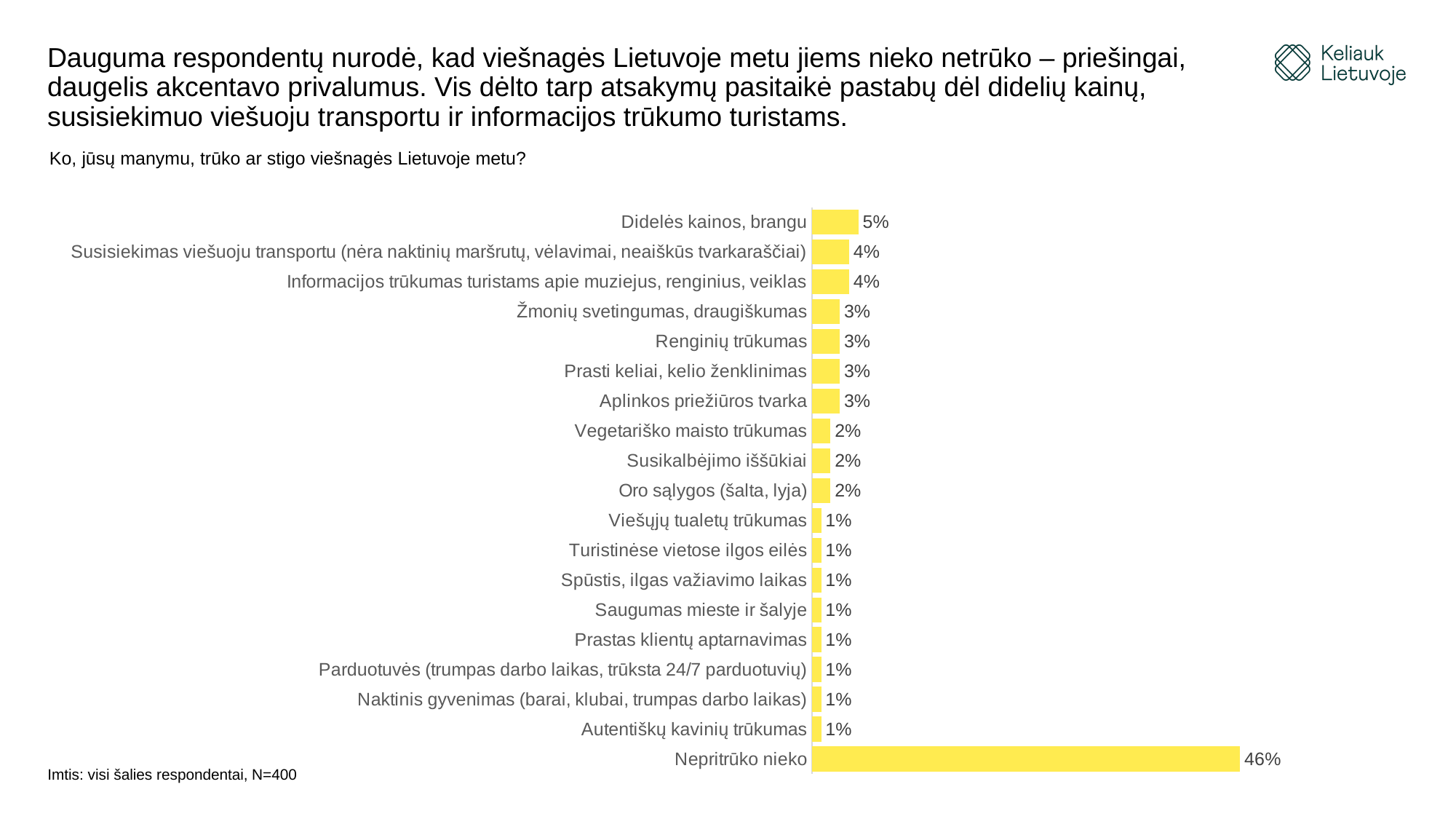
What is the value for "Oro sąlygos (šalta, lyja)"? 2% What type of chart is shown on the slide? Bar chart Which is larger: "Didelės kainos, brangu" or "Vegetariško maisto trūkumas"? Didelės kainos, brangu What colour are the bars in the chart? Yellow How many categories are shown in the chart? 19 Which category has the highest value? Nepritrūko nieko What percentage of respondents answered "Nepritrūko nieko"? 46% What is the value for "Didelės kainos, brangu"? 5% What is the difference between "Didelės kainos, brangu" and "Renginių trūkumas"? 2% What is the difference between "Nepritrūko nieko" and "Didelės kainos, brangu"? 41% What is the value for "Autentiškų kavinių trūkumas"? 1% What is the value for "Informacijos trūkumas turistams apie muziejus, renginius, veiklas"? 4%